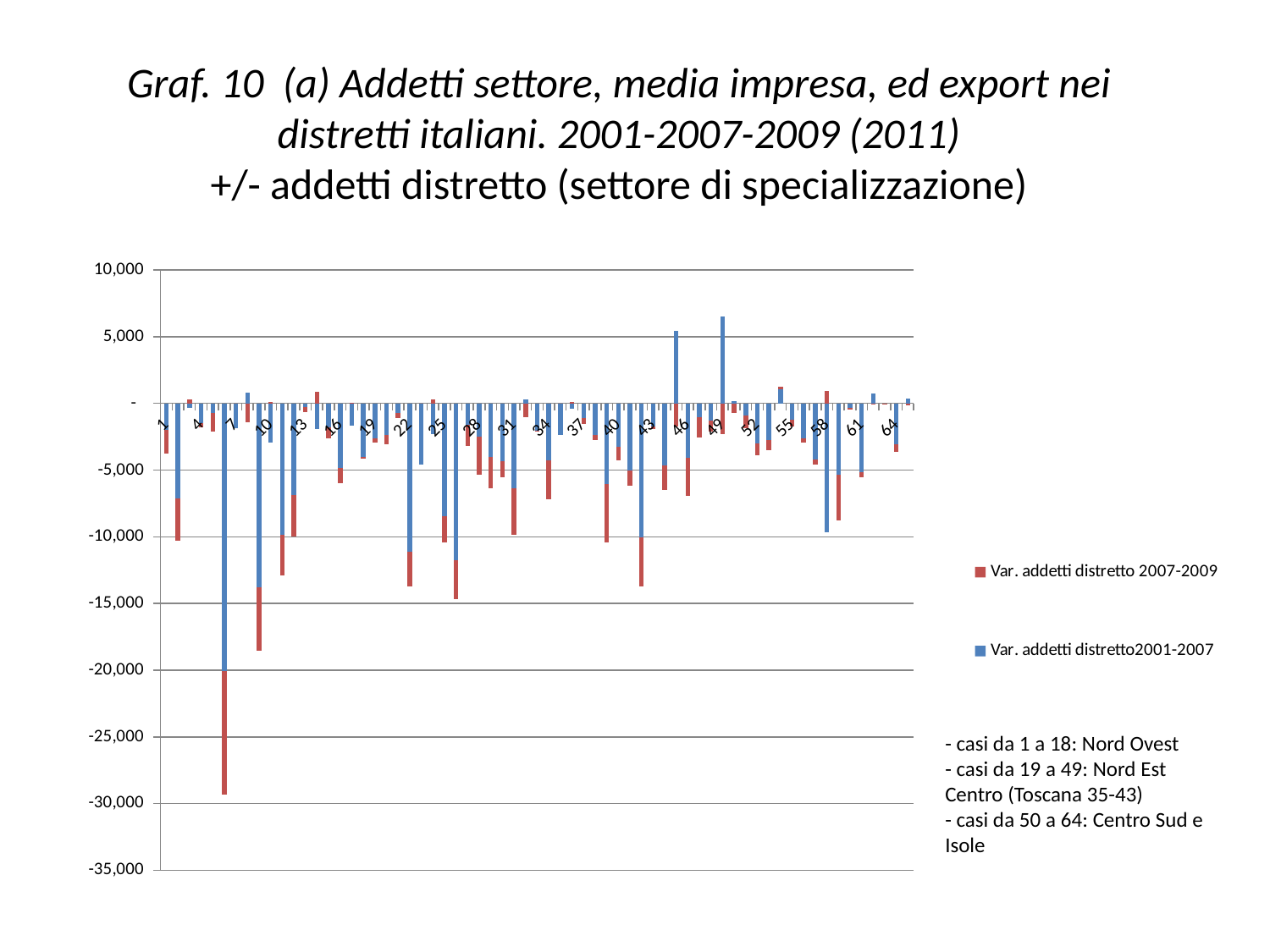
Is the Var. addetti distretto2001-2007 value for case 49 greater or less than 5,000? greater How many cases (categories) are plotted along the x axis? 65 Are most of the bars in the chart above or below zero? below How many series does the legend list? 2 Which is larger, the Var. addetti distretto2001-2007 bar at case 49 or the one at case 46? case 49 What are the two series named in the legend? Var. addetti distretto 2007-2009 and Var. addetti distretto2001-2007 What kind of chart is shown on the slide? bar chart Which case number has the highest positive bar for Var. addetti distretto2001-2007? 49 Which series is drawn in red? Var. addetti distretto 2007-2009 Is the Var. addetti distretto2001-2007 value for case 7 greater or less than -15,000? greater